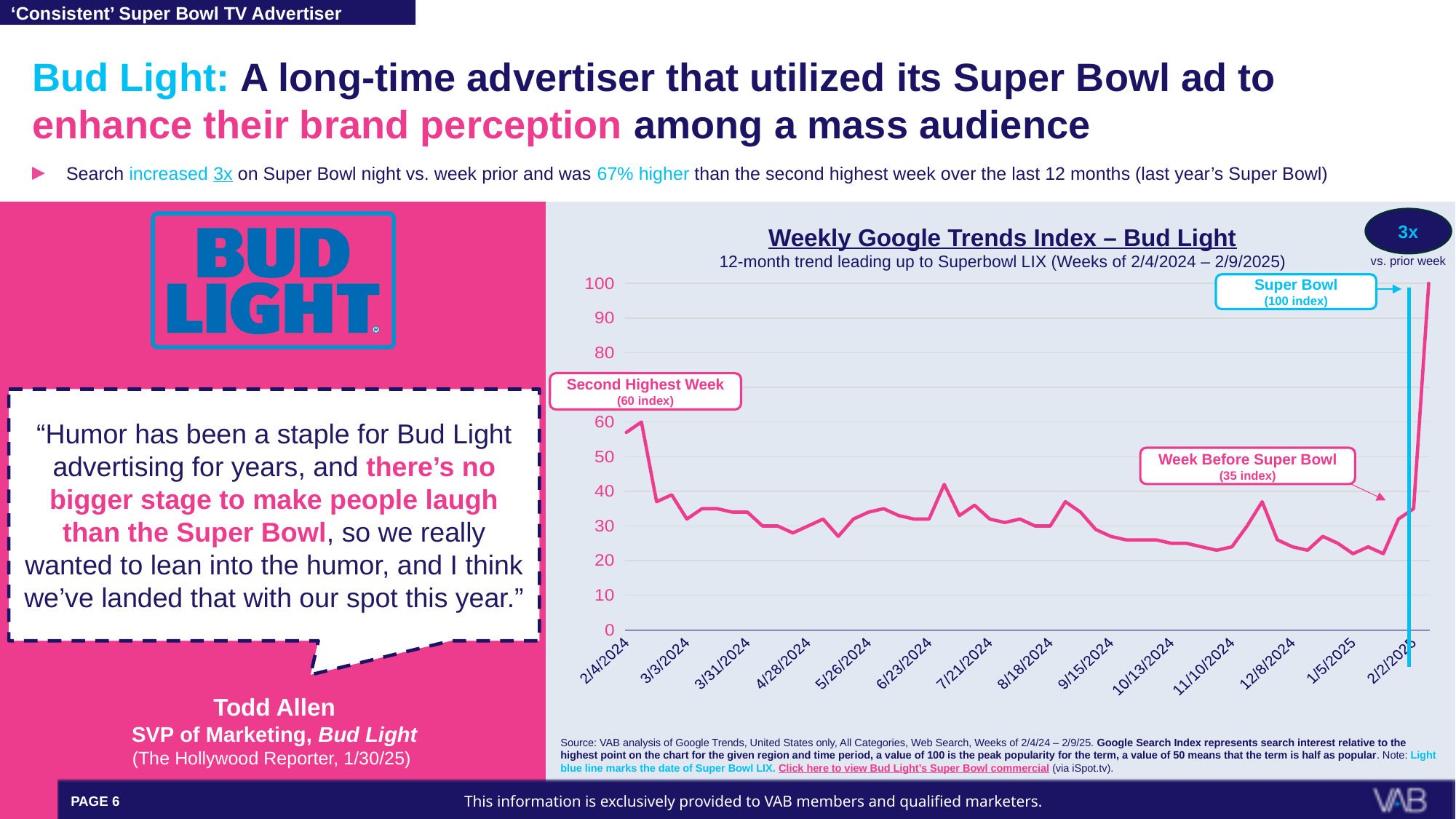
What index value is labeled for the Second Highest Week? 60 What kind of chart is shown on the slide? Line chart What is the title of the chart? Weekly Google Trends Index – Bud Light Is the index value for the week of 2/4/2024 greater or less than 50? greater Which week has the highest index value on the chart? Super Bowl week Is the index value for the week of 1/5/2025 greater or less than 30? less What is the difference between the Super Bowl week index and the Week Before Super Bowl index? 65 Which is larger, the Second Highest Week index or the Week Before Super Bowl index? Second Highest Week What is the difference between the Super Bowl week index and the Second Highest Week index? 40 What does the light blue vertical line on the chart mark? The date of Super Bowl LIX What index value is labeled for the Week Before Super Bowl? 35 What index value does the chart show for the Super Bowl week? 100